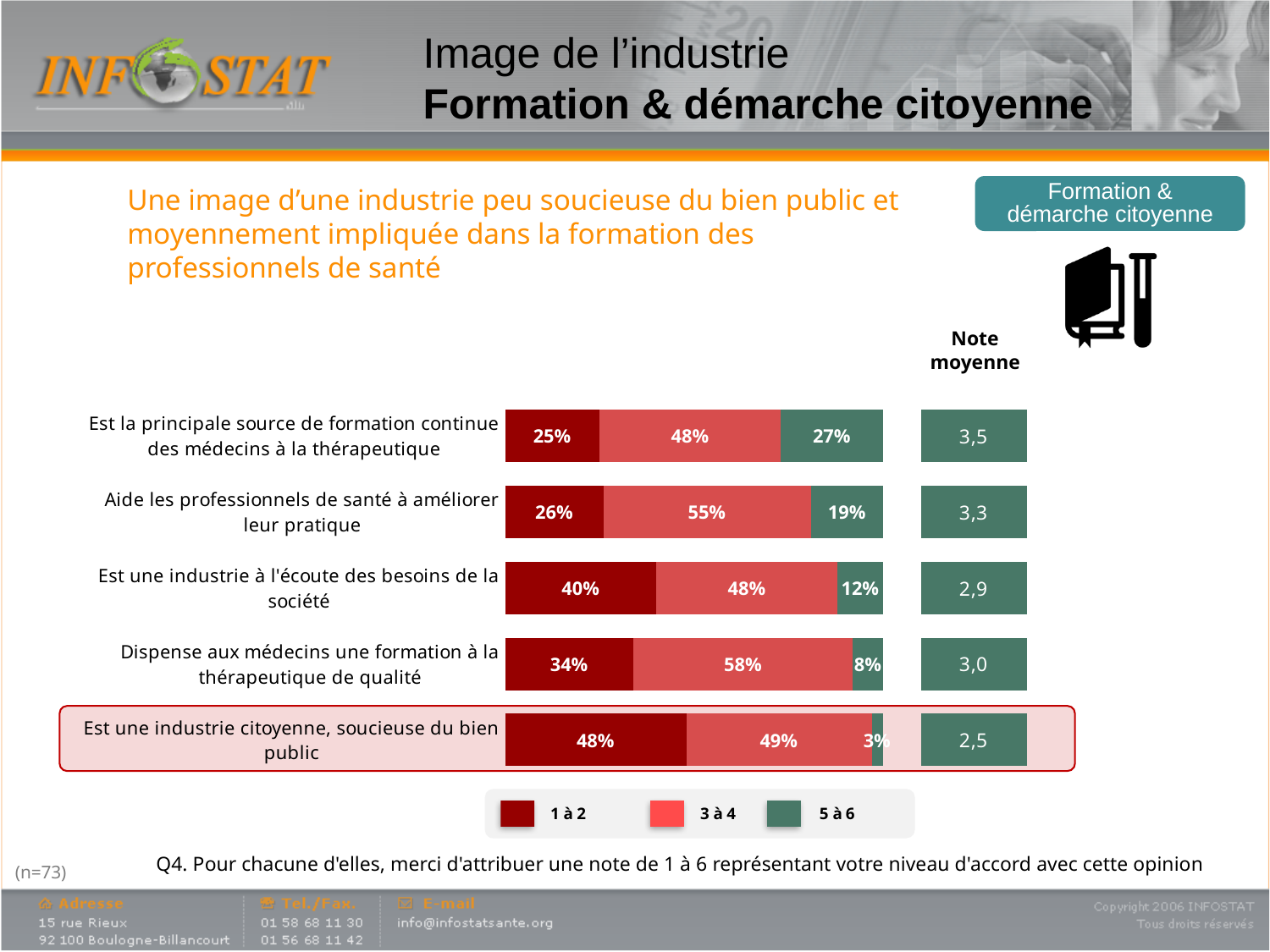
What percentage gave a score of 5 à 6 for "Est la principale source de formation continue des médecins à la thérapeutique"? 27% Which has a larger 3 à 4 share: "Aide les professionnels de santé à améliorer leur pratique" or "Est une industrie à l'écoute des besoins de la société"? Aide les professionnels de santé à améliorer leur pratique How many series does the legend list? 3 What is the Note moyenne for "Est une industrie à l'écoute des besoins de la société"? 2,9 What percentage of respondents gave a score of 1 à 2 for "Est une industrie citoyenne, soucieuse du bien public"? 48% Which legend entry is shown in dark red? 1 à 2 What is the 3 à 4 share for "Dispense aux médecins une formation à la thérapeutique de qualité"? 58% What is the difference between the 1 à 2 shares for "Est une industrie citoyenne, soucieuse du bien public" and "Est la principale source de formation continue des médecins à la thérapeutique"? 23 percentage points Which statement has the lowest 5 à 6 share? Est une industrie citoyenne, soucieuse du bien public Which statement has the highest Note moyenne? Est la principale source de formation continue des médecins à la thérapeutique What kind of chart is shown on the slide? Stacked bar chart How many statements (categories) are plotted in the chart? 5